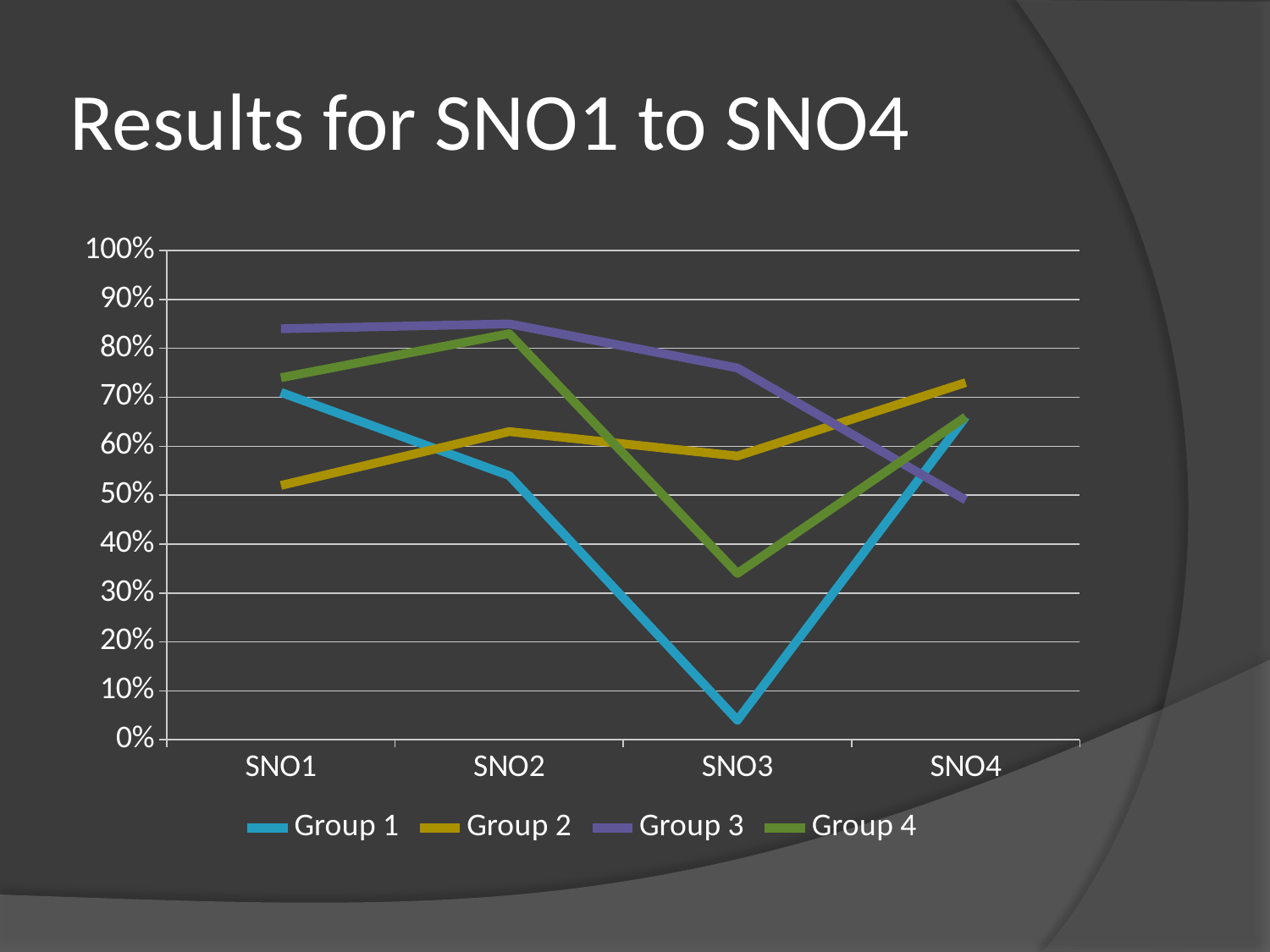
How many categories are shown on the x axis? 4 Is the value for Group 3 at SNO1 greater or less than 80%? greater Which group has the highest value at SNO3? Group 3 Does the value for Group 3 rise or fall from SNO2 to SNO4? fall Is the value for Group 4 at SNO3 greater or less than 40%? less At which category does Group 1 reach its lowest value? SNO3 At SNO4, which is larger: Group 2 or Group 3? Group 2 What is the title of the slide containing the chart? Results for SNO1 to SNO4 Is the value for Group 1 at SNO3 greater or less than 10%? less Which group has the lowest value at SNO1? Group 2 What kind of chart is shown on the slide? line chart How many series does the legend list? 4